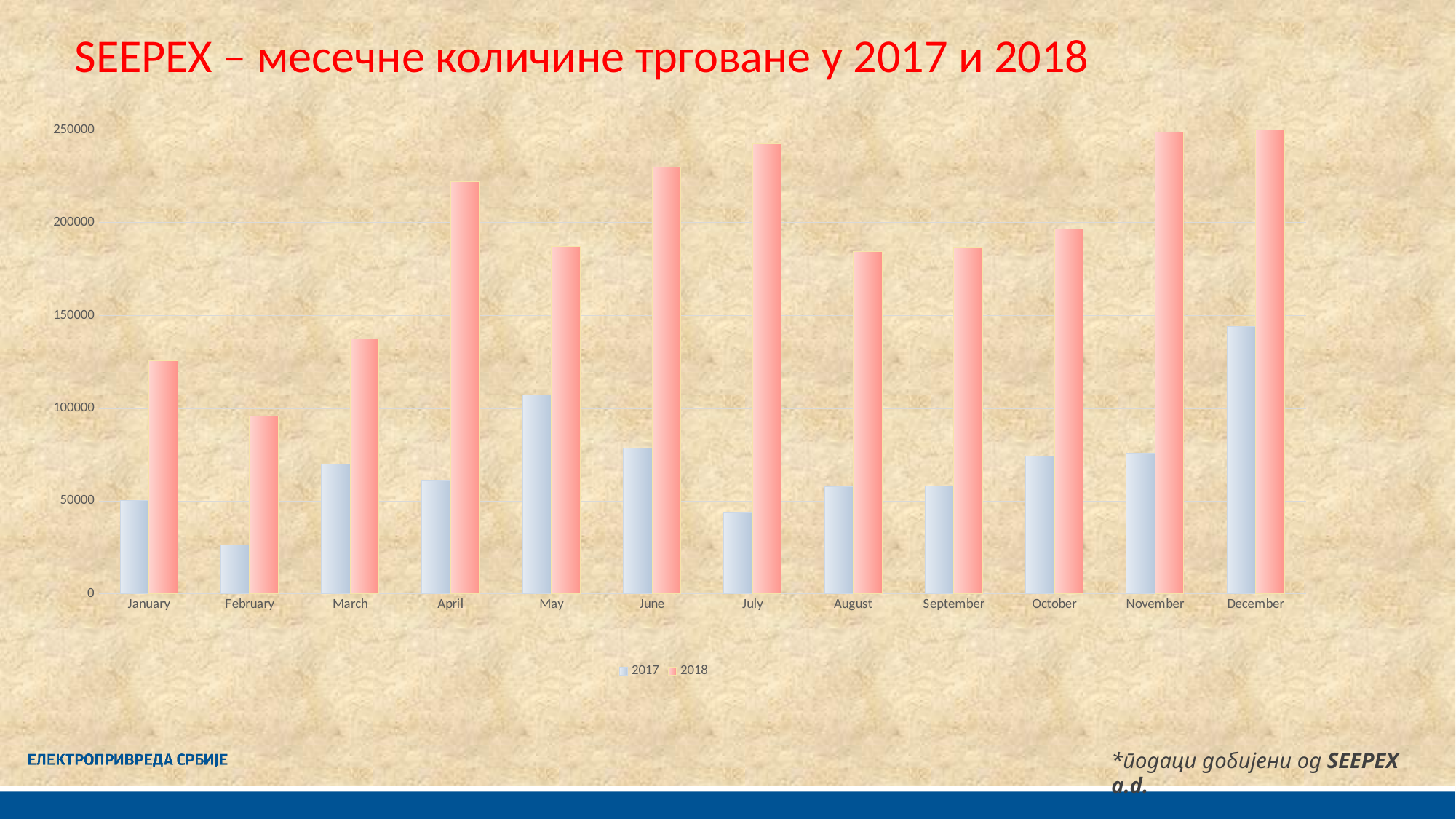
What are the two entries in the chart legend? 2017 and 2018 How many series does the legend list? 2 Is the 2018 value for July greater or less than 200000? greater Which month has the lowest value for the 2017 series? February What kind of chart is shown on the slide? bar chart Which is larger for 2018: the value for April or the value for May? April How many months are shown on the x axis? 12 Which month has the lowest value for the 2018 series? February Is the 2017 value for May greater or less than 100000? greater Is the 2017 value for February greater or less than 50000? less Which month has the highest value for the 2017 series? December